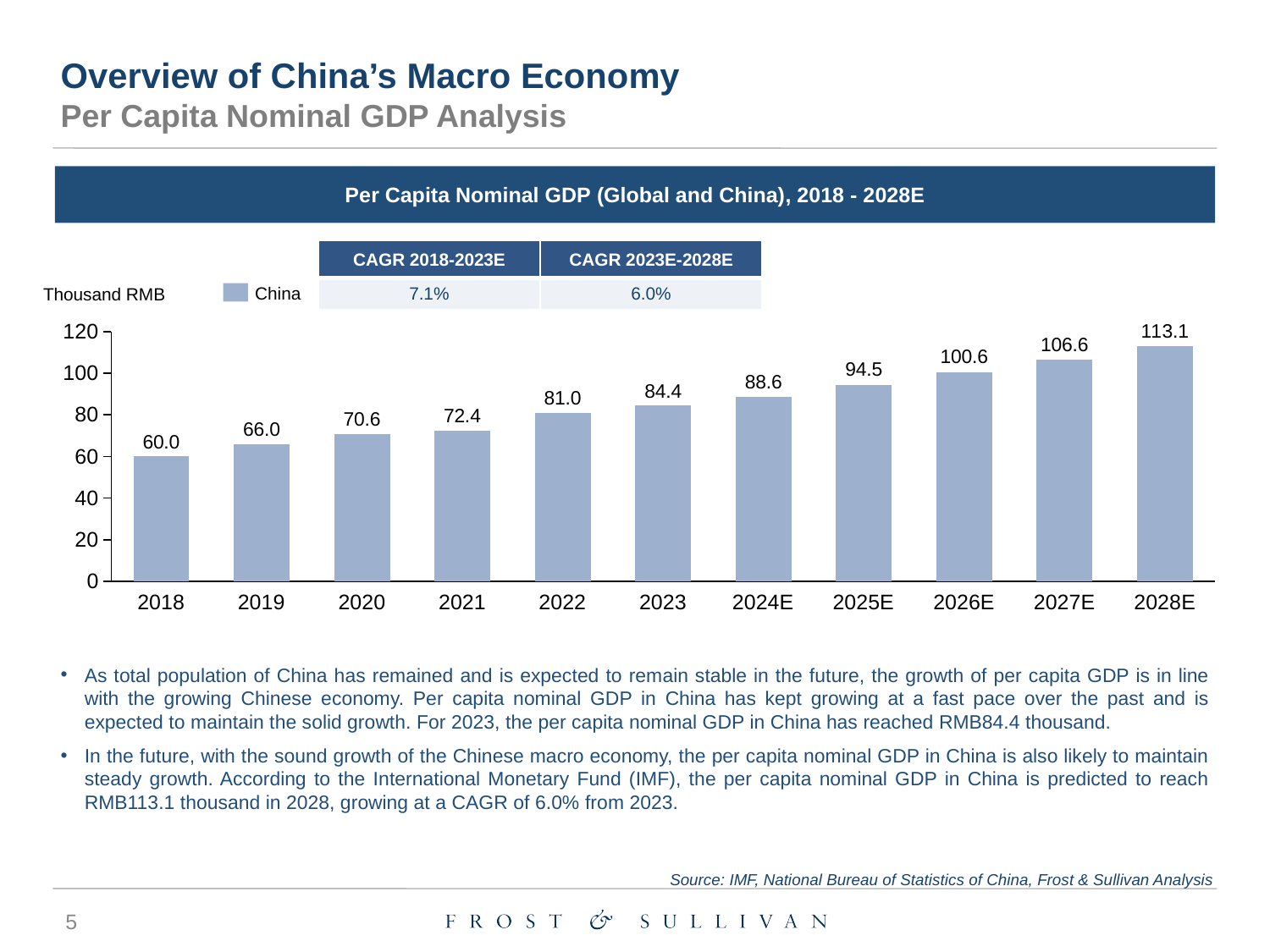
What kind of chart is shown? bar chart Which year has the lowest per capita nominal GDP value? 2018 Do the values rise or fall from 2018 to 2028E? rise What is the per capita nominal GDP value for 2023? 84.4 How many years are shown on the x axis? 11 What is the difference between the values for 2028E and 2023? 28.7 Which is larger, the value for 2022 or the value for 2021? 2022 What is the value shown for 2026E? 100.6 What is the per capita nominal GDP value for 2018? 60.0 Which year has the highest per capita nominal GDP value? 2028E What is the difference between the values for 2019 and 2018? 6.0 How many series does the legend list? 1